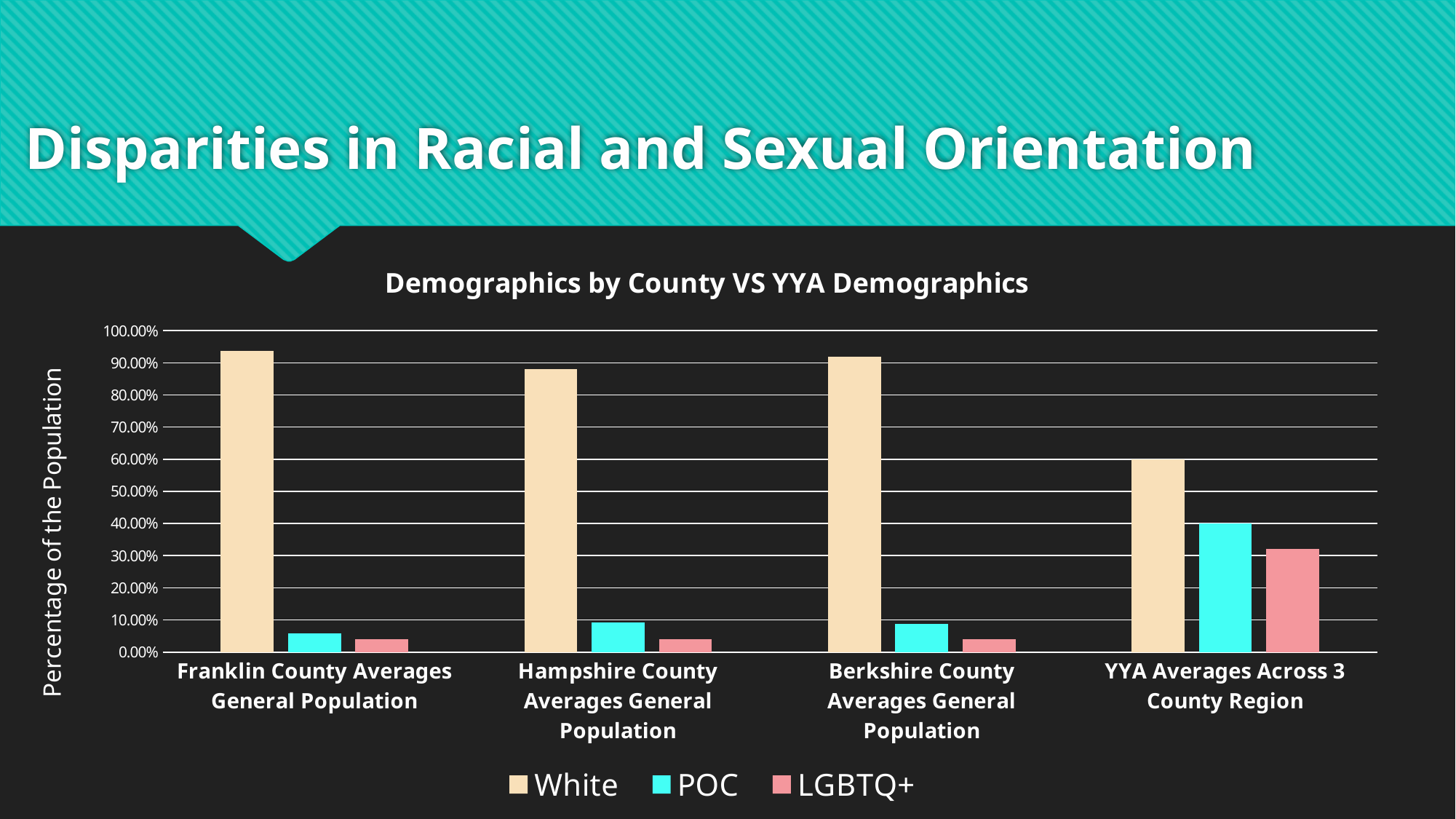
Which category has the highest White value? Franklin County Averages General Population What is the title of the chart? Demographics by County VS YYA Demographics What is the label of the y axis? Percentage of the Population Is the LGBTQ+ value for YYA Averages Across 3 County Region greater or less than 30.00%? greater Which is larger for YYA Averages Across 3 County Region, the POC value or the LGBTQ+ value? POC Which category has the highest POC value? YYA Averages Across 3 County Region What kind of chart is shown on the slide? bar chart Is the White value for Hampshire County Averages General Population greater or less than 80.00%? greater How many series does the legend list? 3 Which category has the lowest White value? YYA Averages Across 3 County Region Is the POC value for Franklin County Averages General Population greater or less than 10.00%? less How many categories are shown along the x axis? 4